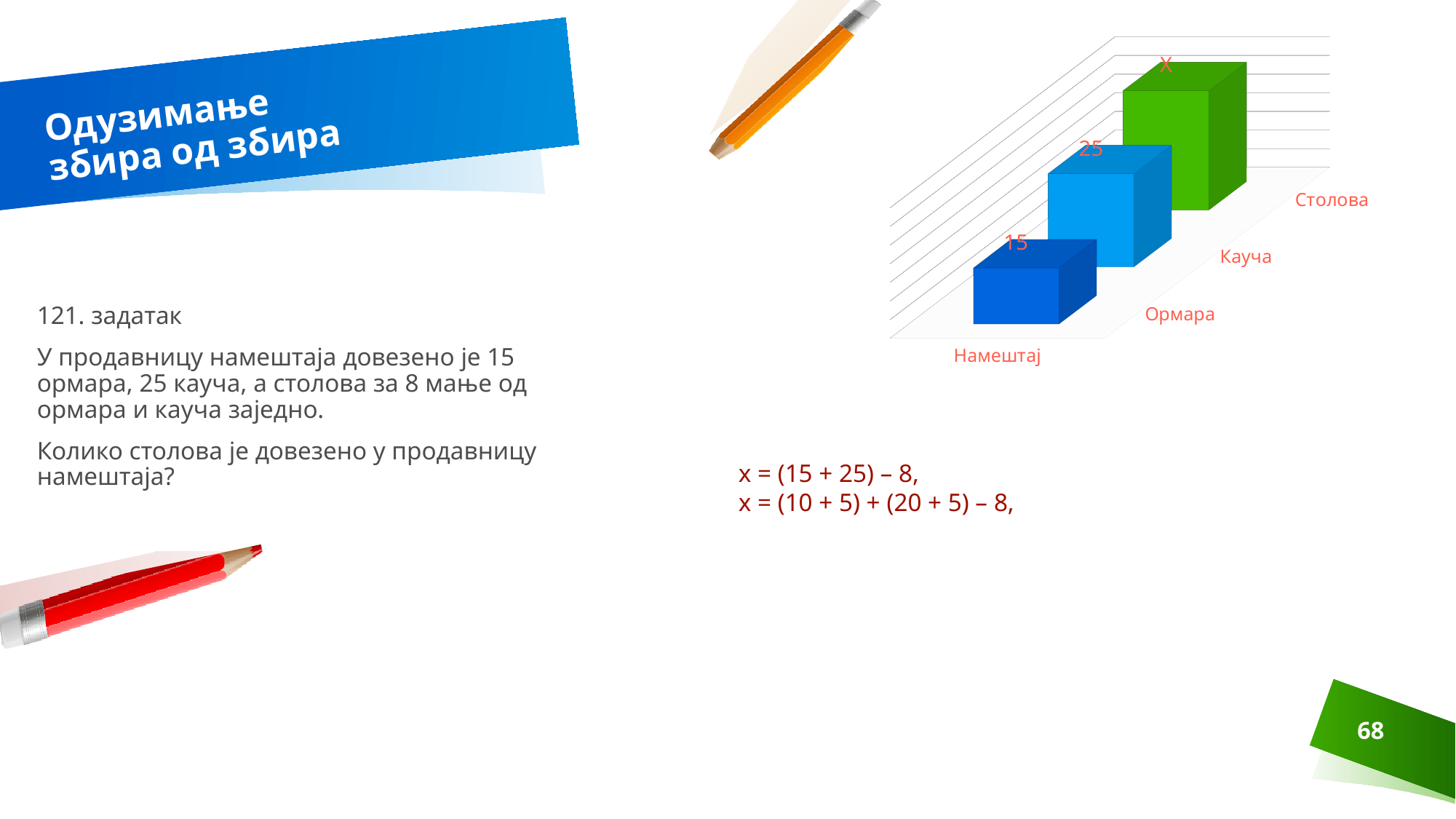
Which is larger in the chart, the value for Кауча or the value for Ормара? Кауча How many categories are plotted in the chart? 3 What label is shown on the bar for Столова in the chart? x What kind of chart is shown on the slide? bar chart Which category has the shortest bar in the chart? Ормара What is the difference between the values for Кауча and Ормара in the chart? 10 What is the label written below the category axis of the chart? Намештај What value is shown for Ормара in the chart? 15 What colour is the bar for Столова in the chart? green Do the bars rise or fall from Ормара to Столова along the category axis? rise What value is shown for Кауча in the chart? 25 Which category has the tallest bar in the chart? Столова